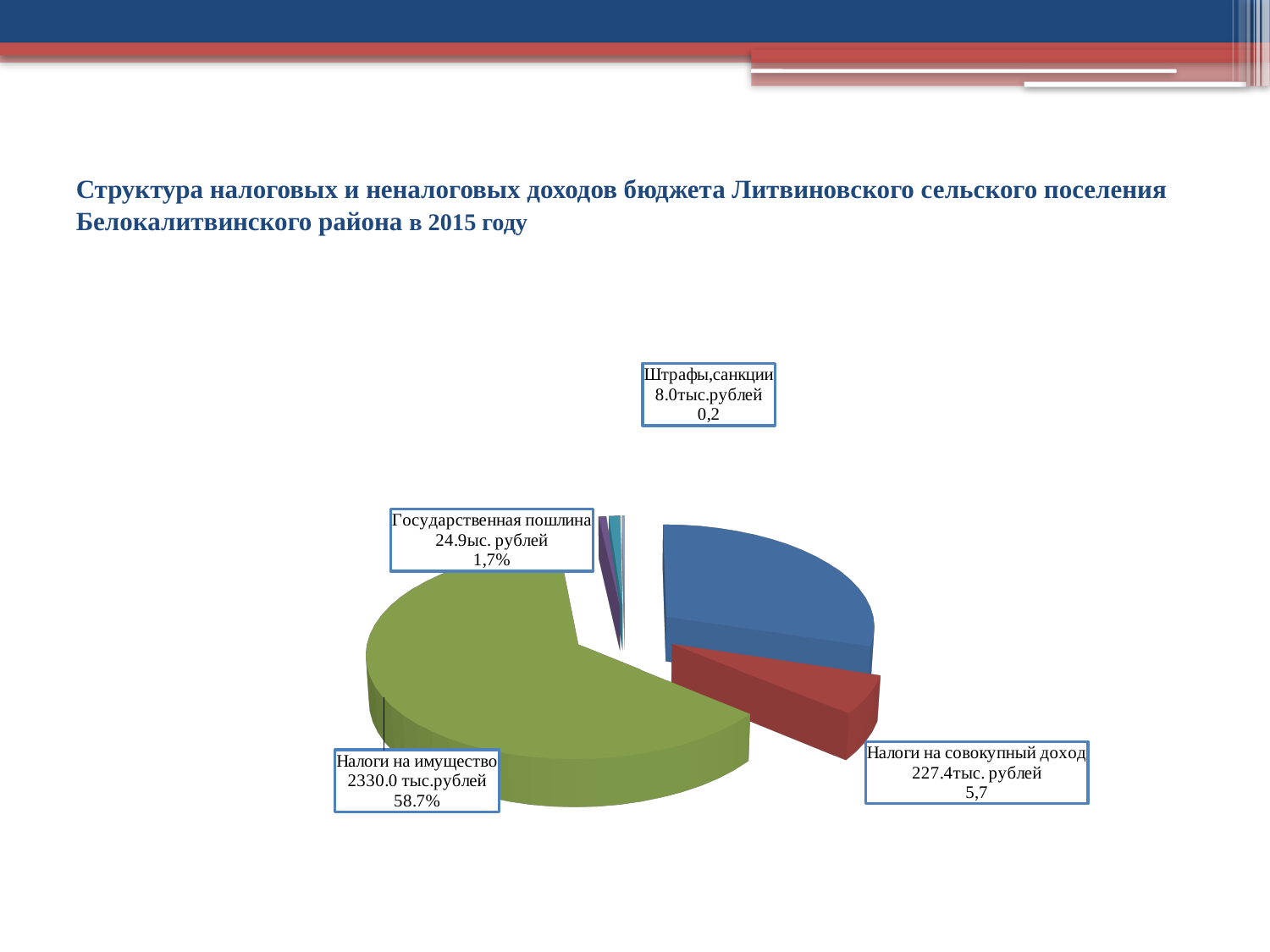
What year does the chart title refer to? 2015 What share of the pie does Налоги на имущество represent? 58.7% What amount is shown for Штрафы,санкции? 8.0 тыс.рублей What is the difference between the amounts for Налоги на имущество and Налоги на совокупный доход? 2102.6 тыс. рублей What amount is shown for Государственная пошлина? 24.9 тыс. рублей Which labelled category has the largest slice of the pie? Налоги на имущество Which labelled category has the smallest value? Штрафы,санкции What share is shown for Государственная пошлина? 1,7% What amount is shown for Налоги на совокупный доход? 227.4 тыс. рублей What amount is shown for Налоги на имущество? 2330.0 тыс.рублей What type of chart is shown on the slide? Pie chart Which is larger, Налоги на совокупный доход or Государственная пошлина? Налоги на совокупный доход